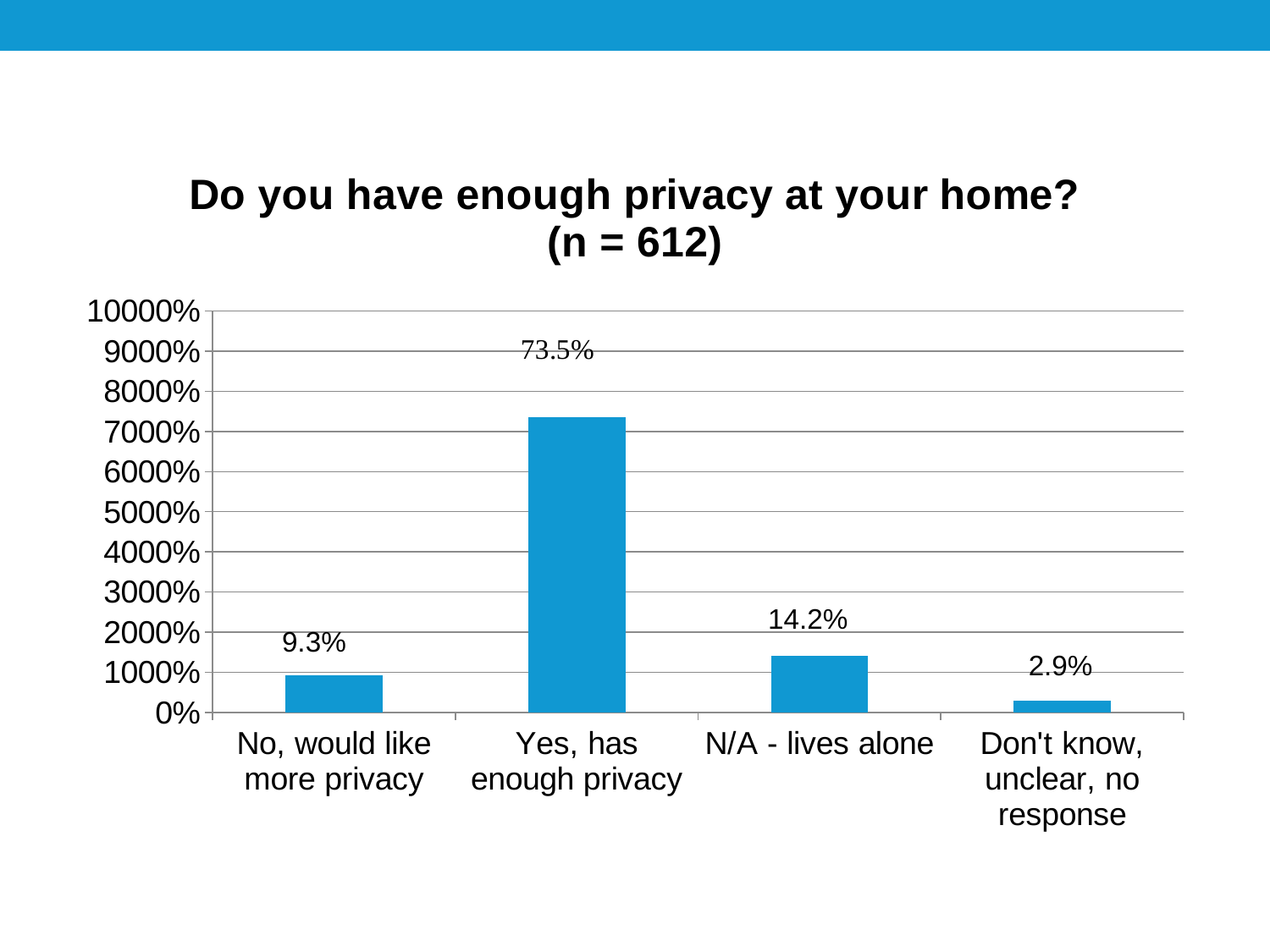
What type of chart is shown on the slide? Bar chart What is the value shown for "N/A - lives alone"? 14.2% What is the value shown for "Don't know, unclear, no response"? 2.9% What percentage of respondents answered "No, would like more privacy"? 9.3% Which is larger: the value for "N/A - lives alone" or the value for "No, would like more privacy"? N/A - lives alone What percentage of respondents answered "Yes, has enough privacy"? 73.5% What is the difference between the values for "N/A - lives alone" and "Don't know, unclear, no response"? 11.3% Which response category has the lowest value? Don't know, unclear, no response What sample size (n) is given in the chart title? 612 What is the difference between the values for "Yes, has enough privacy" and "No, would like more privacy"? 64.2% How many response categories are shown on the chart? 4 Which response category has the highest value? Yes, has enough privacy